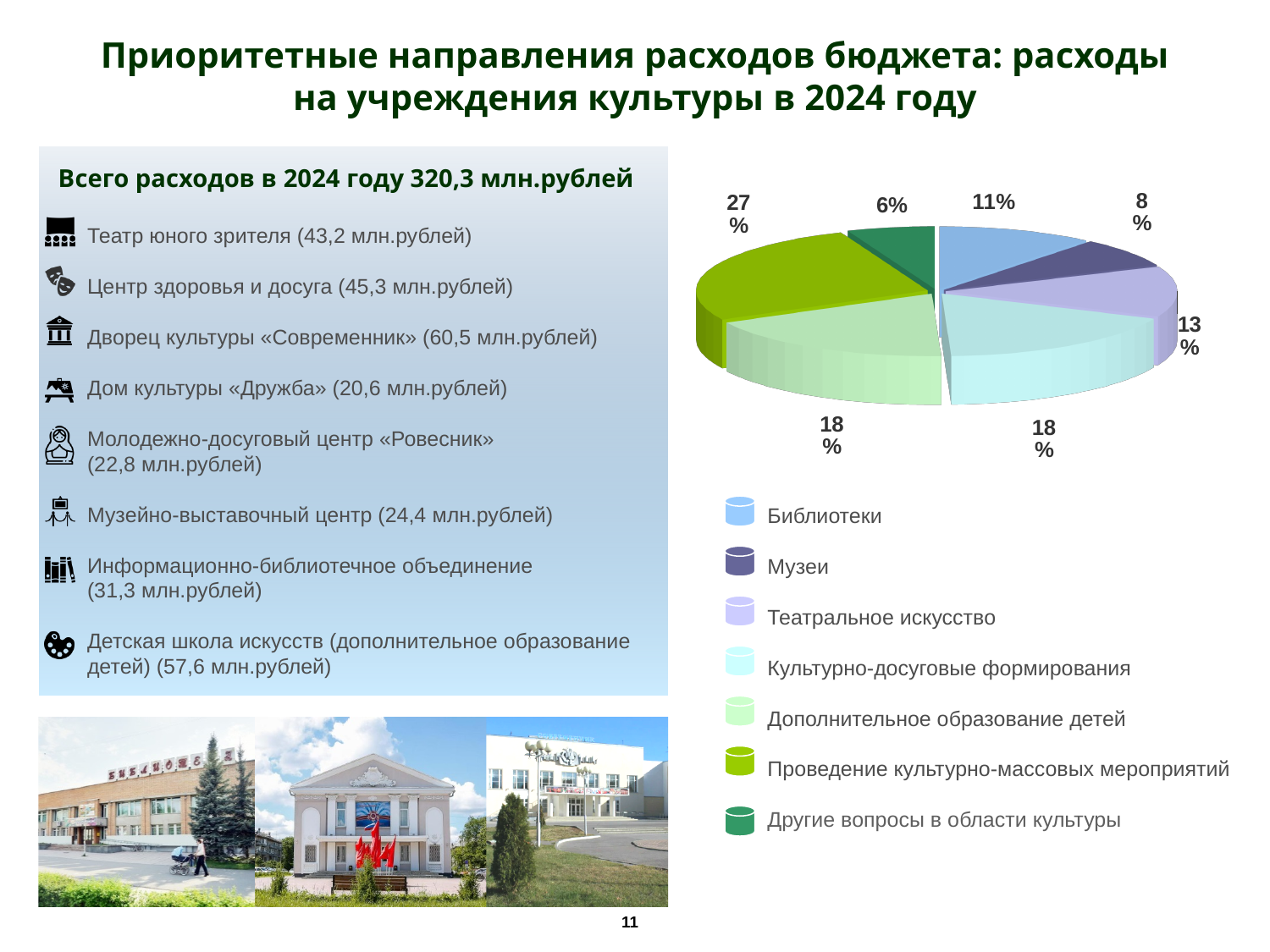
How many categories does the pie chart legend list? 7 Which category has the largest slice of the pie chart? Проведение культурно-массовых мероприятий What share of the pie chart is Другие вопросы в области культуры? 6% What share of the pie chart is Музеи? 8% What is the difference in percentage points between the Проведение культурно-массовых мероприятий slice and the Театральное искусство slice? 14 What share of the pie chart is Театральное искусство? 13% Which category has the smallest slice of the pie chart? Другие вопросы в области культуры What is the total expenditure in 2024 stated on the slide? 320,3 млн.рублей What kind of chart is shown on the slide? pie chart Which slice is larger: Библиотеки or Музеи? Библиотеки